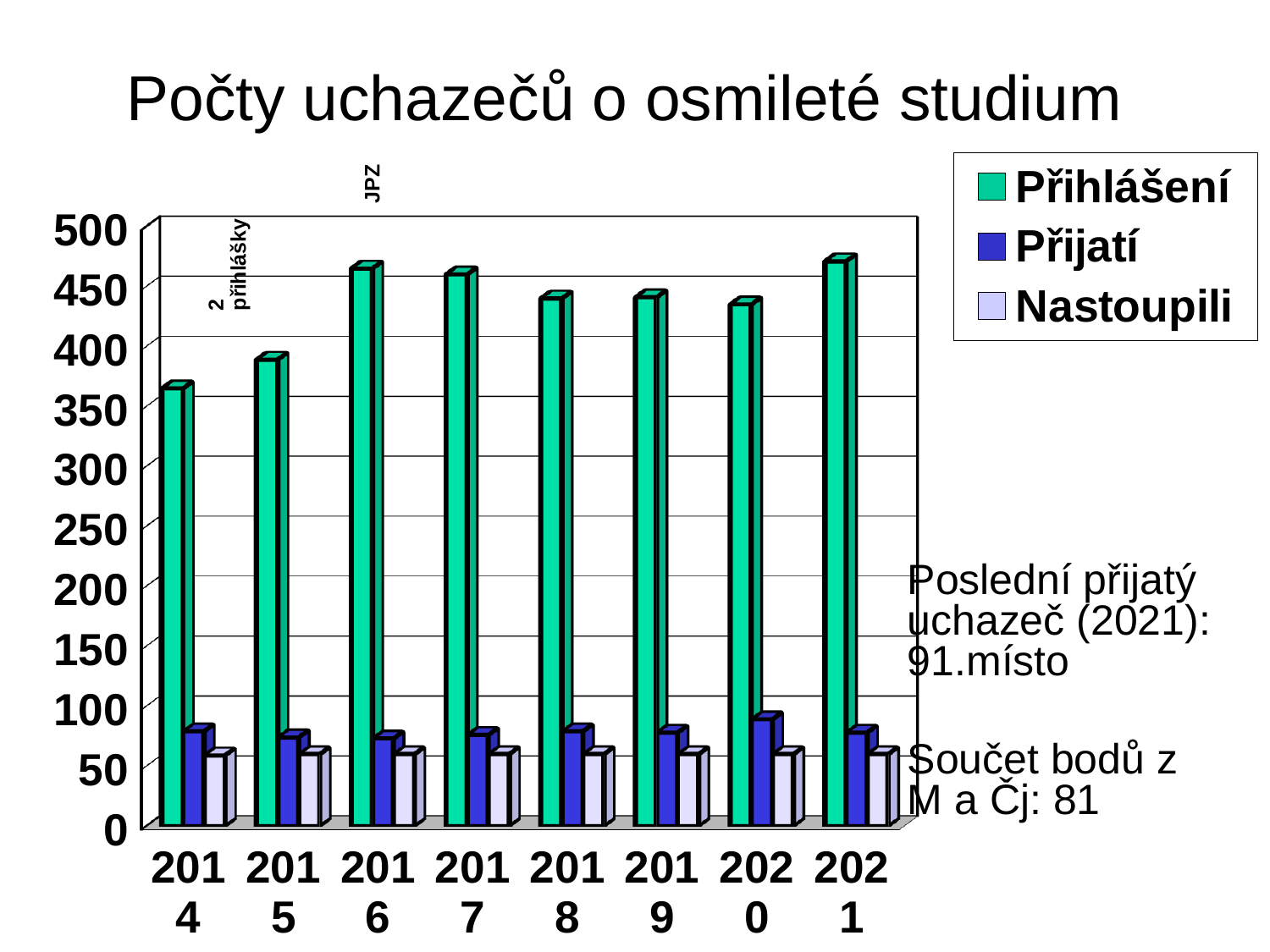
What kind of chart is shown on the slide? bar chart Do the Přihlášení values rise or fall from 2014 to 2016? rise What is the title of the slide? Počty uchazečů o osmileté studium Is the value for Přihlášení in 2021 greater or less than 450? greater Is the value for Přijatí in 2020 greater or less than 100? less How many series does the legend list? 3 Which year has the lowest value for Přihlášení? 2014 In 2021, which is larger, Přijatí or Nastoupili? Přijatí Is the value for Nastoupili in 2018 greater or less than 100? less How many years are shown on the x axis? 8 Which is larger, Přihlášení in 2016 or Přihlášení in 2014? 2016